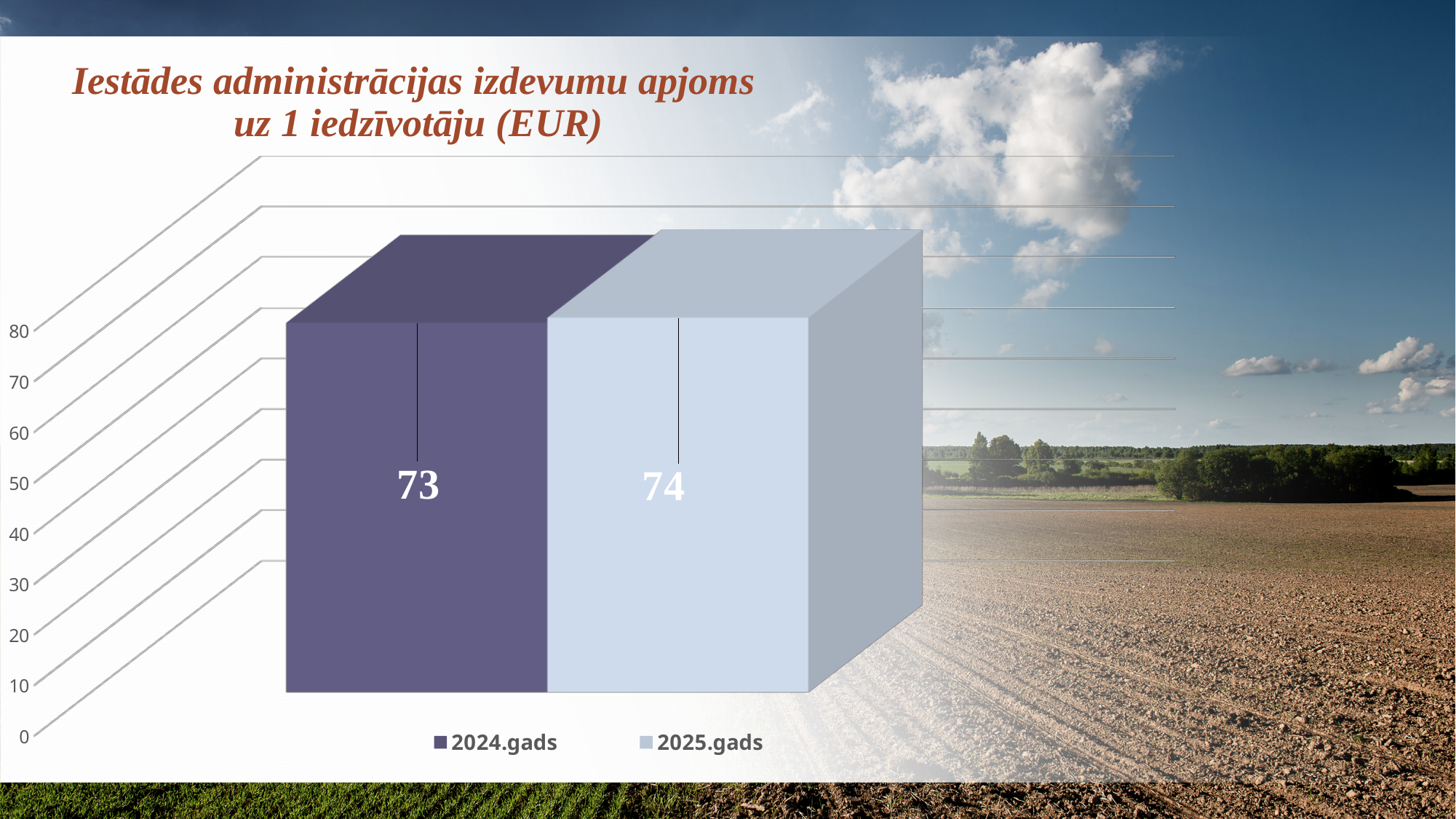
What kind of chart is shown on the slide? Bar chart What is the value for 2024.gads? 73 What is the value for 2025.gads? 74 What is the highest value shown on the vertical axis? 80 How many series does the legend list? 2 Which series has the lowest value? 2024.gads Is the value for 2024.gads greater or less than 70? greater What is the difference between the 2025.gads value and the 2024.gads value? 1 What is the title of the chart? Iestādes administrācijas izdevumu apjoms uz 1 iedzīvotāju (EUR) Is the value for 2025.gads greater or less than 80? less Which series has the highest value? 2025.gads Which series has the higher value, 2024.gads or 2025.gads? 2025.gads